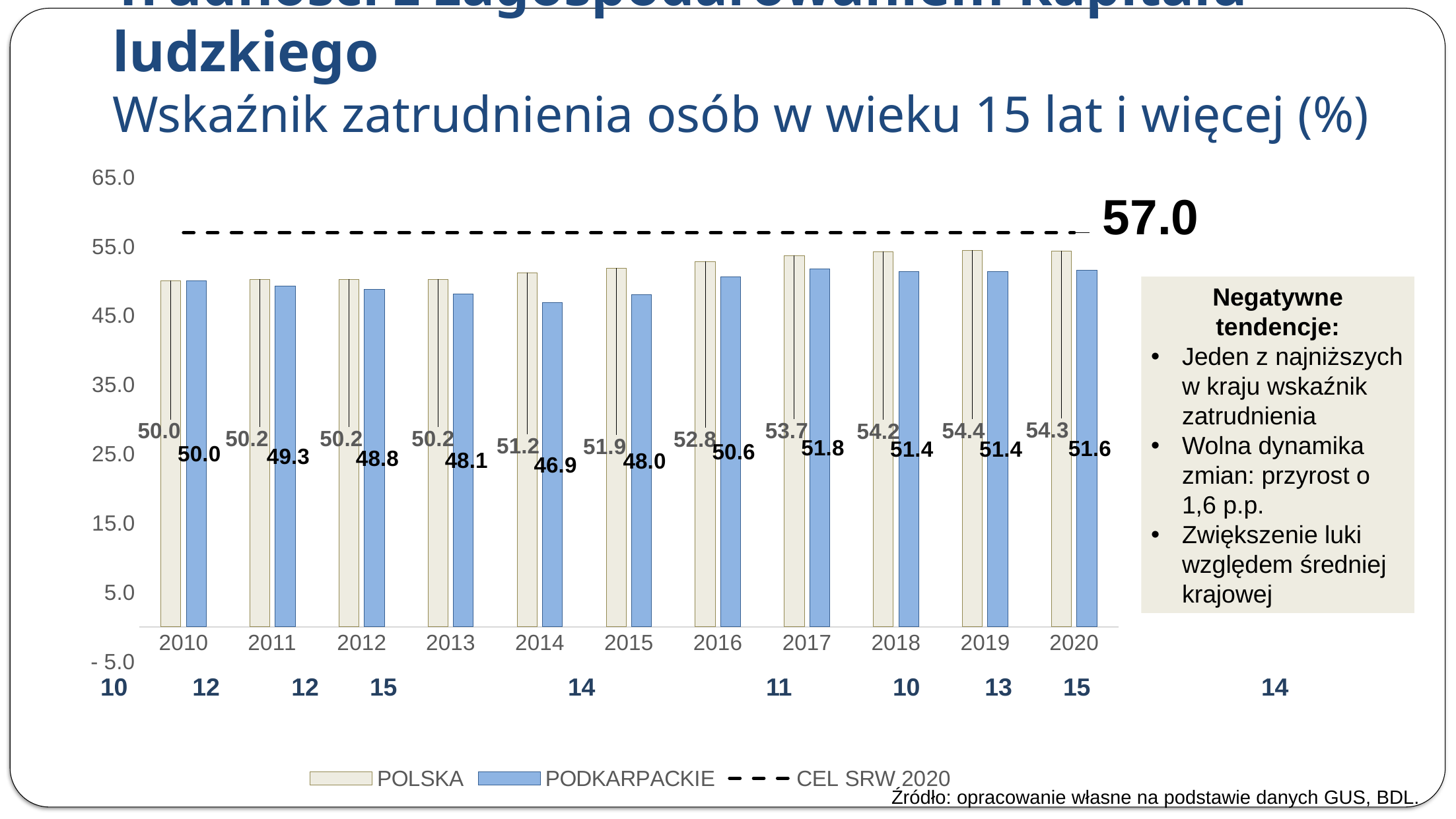
In which year is the POLSKA value highest? 2019 What is the value for PODKARPACKIE in 2020? 51.6 In which year is the PODKARPACKIE value lowest? 2014 Does the POLSKA value rise or fall from 2010 to 2019? rise What is the value for POLSKA in 2017? 53.7 What value is shown for the CEL SRW 2020 dashed line? 57.0 What is the value for PODKARPACKIE in 2014? 46.9 How many series does the legend list? 3 How many years are shown on the x axis? 11 Which is larger in 2015, the POLSKA value or the PODKARPACKIE value? POLSKA What is the difference between the POLSKA and PODKARPACKIE values in 2020? 2.7 What kind of chart is shown on the slide? combination bar and line chart